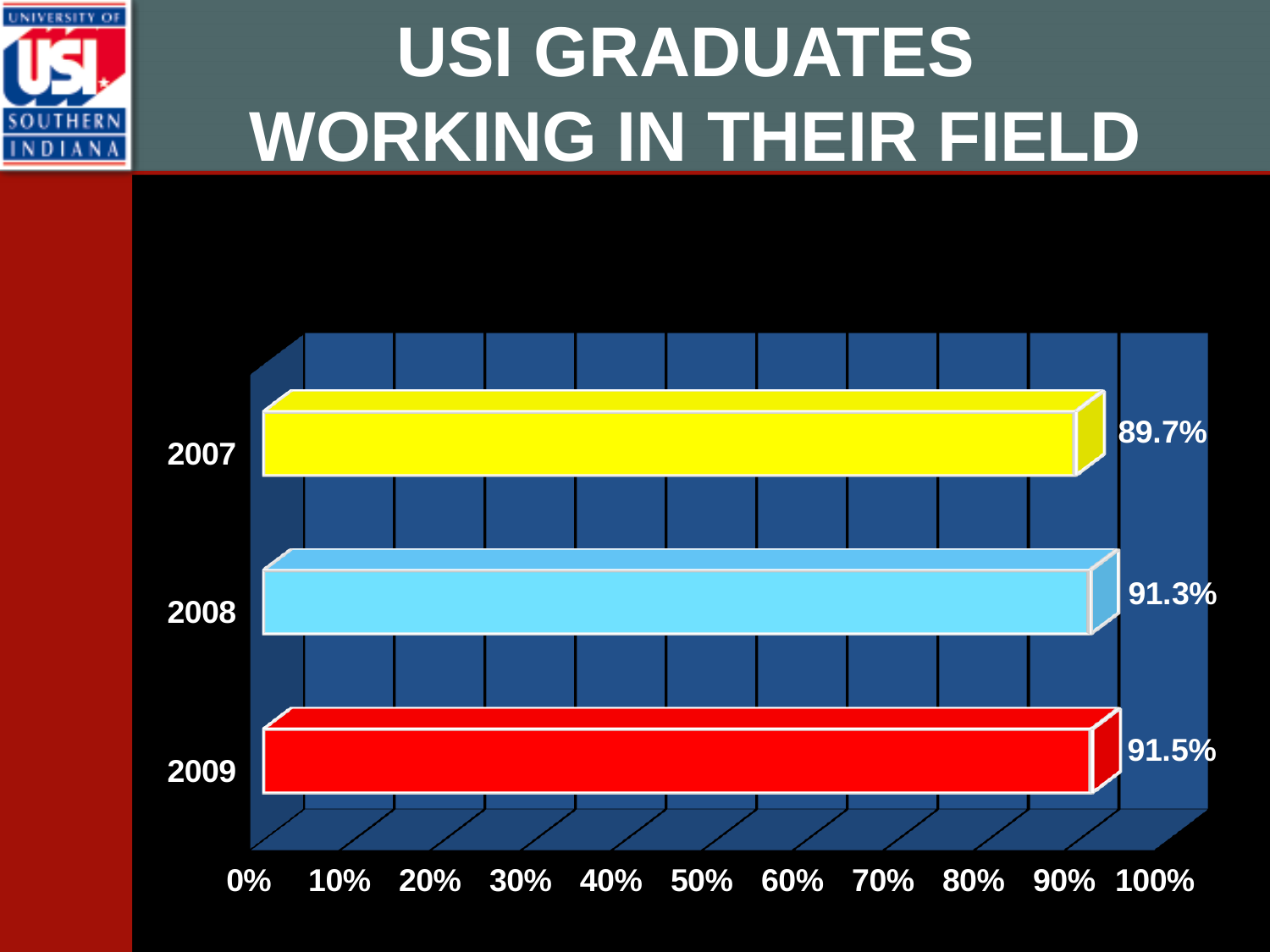
Is the value for 2007 greater or less than 90%? less What is the difference in percentage points between 2009 and 2007? 1.8 What percentage of USI graduates were working in their field in 2007? 89.7% Which is larger, the value for 2007 or the value for 2008? 2008 How many years are shown in the chart? 3 What percentage of USI graduates were working in their field in 2009? 91.5% What kind of chart is shown on the slide? bar chart Is the value for 2009 greater or less than 90%? greater What is the difference in percentage points between 2008 and 2007? 1.6 What percentage of USI graduates were working in their field in 2008? 91.3% Which year has the lowest percentage of graduates working in their field? 2007 What colour is the bar for 2009? red